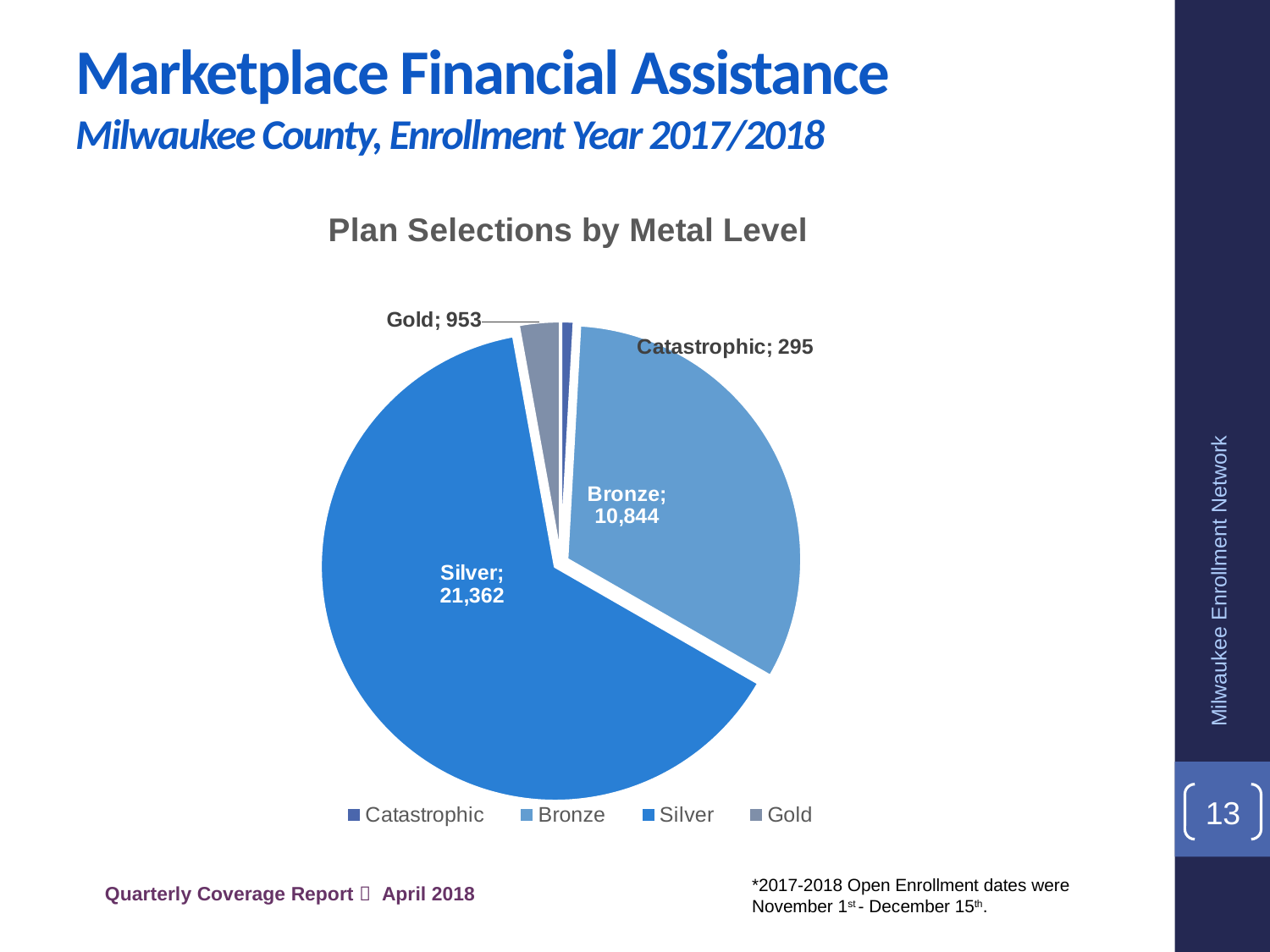
What is the title of the chart? Plan Selections by Metal Level How many plan selections are shown for Catastrophic? 295 Which has more plan selections, Gold or Catastrophic? Gold Which metal level has the largest number of plan selections? Silver How many plan selections are shown for Silver? 21,362 How many metal levels (slices) does the pie chart show? 4 Which metal level has the smallest number of plan selections? Catastrophic What kind of chart is shown on the slide? Pie chart What is the difference between the Silver and Bronze plan selections? 10,518 How many plan selections are shown for Bronze? 10,844 What is the total number of plan selections across all metal levels? 33,454 How many plan selections are shown for Gold? 953